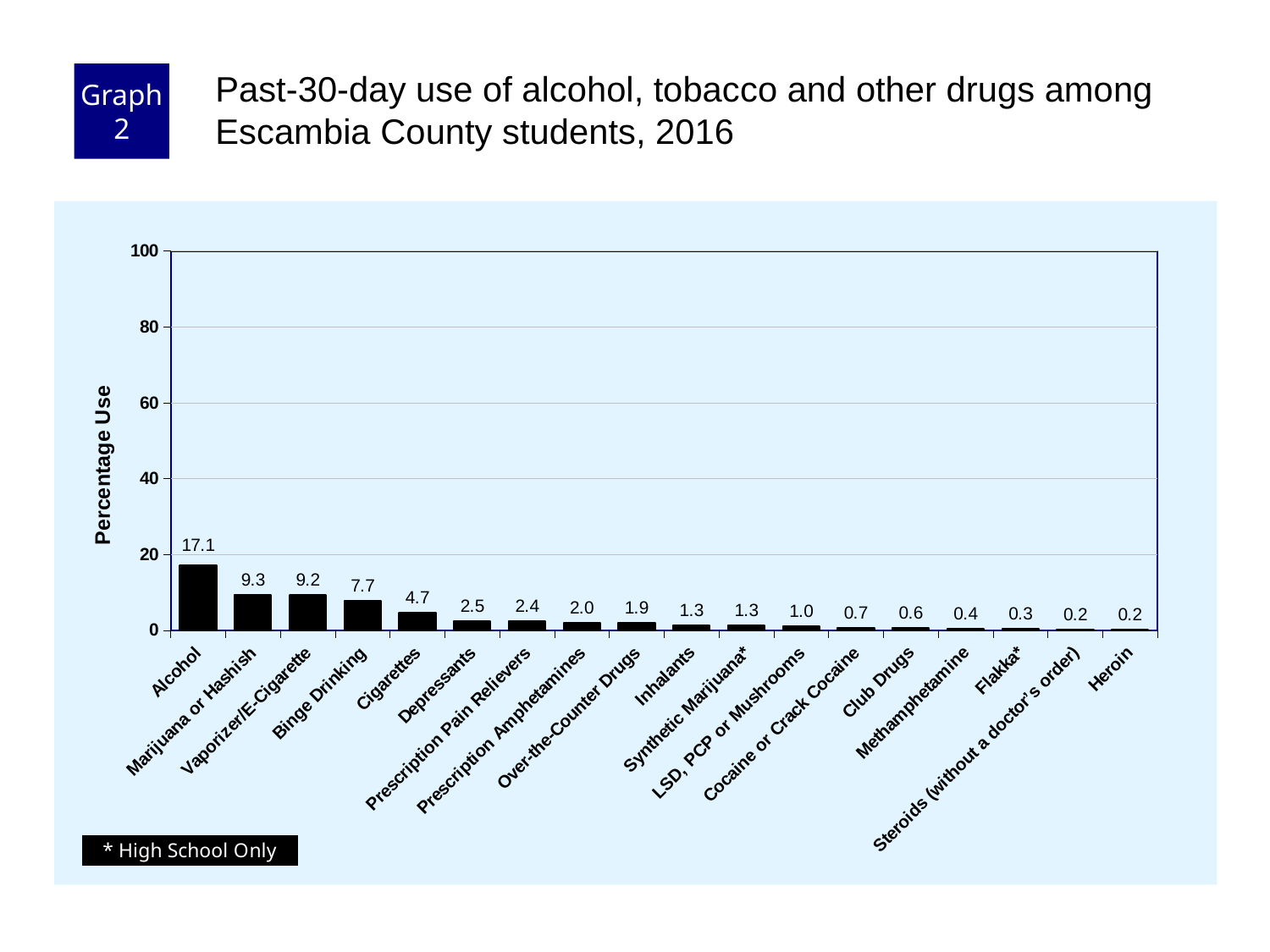
Which is larger, the value for Binge Drinking or the value for Cigarettes? Binge Drinking What value is shown for Vaporizer/E-Cigarette? 9.2 Which category has the highest percentage use? Alcohol What value is shown for Inhalants? 1.3 Is the value for Alcohol greater or less than 20? less What kind of chart is shown on the slide? bar chart What is the past-30-day use percentage for Alcohol? 17.1 What is the difference between the values for Cigarettes and Depressants? 2.2 Do the values rise or fall moving from left to right along the x axis? fall How many categories are shown on the x axis? 18 What value is shown for Methamphetamine? 0.4 What is the difference between the values for Alcohol and Marijuana or Hashish? 7.8